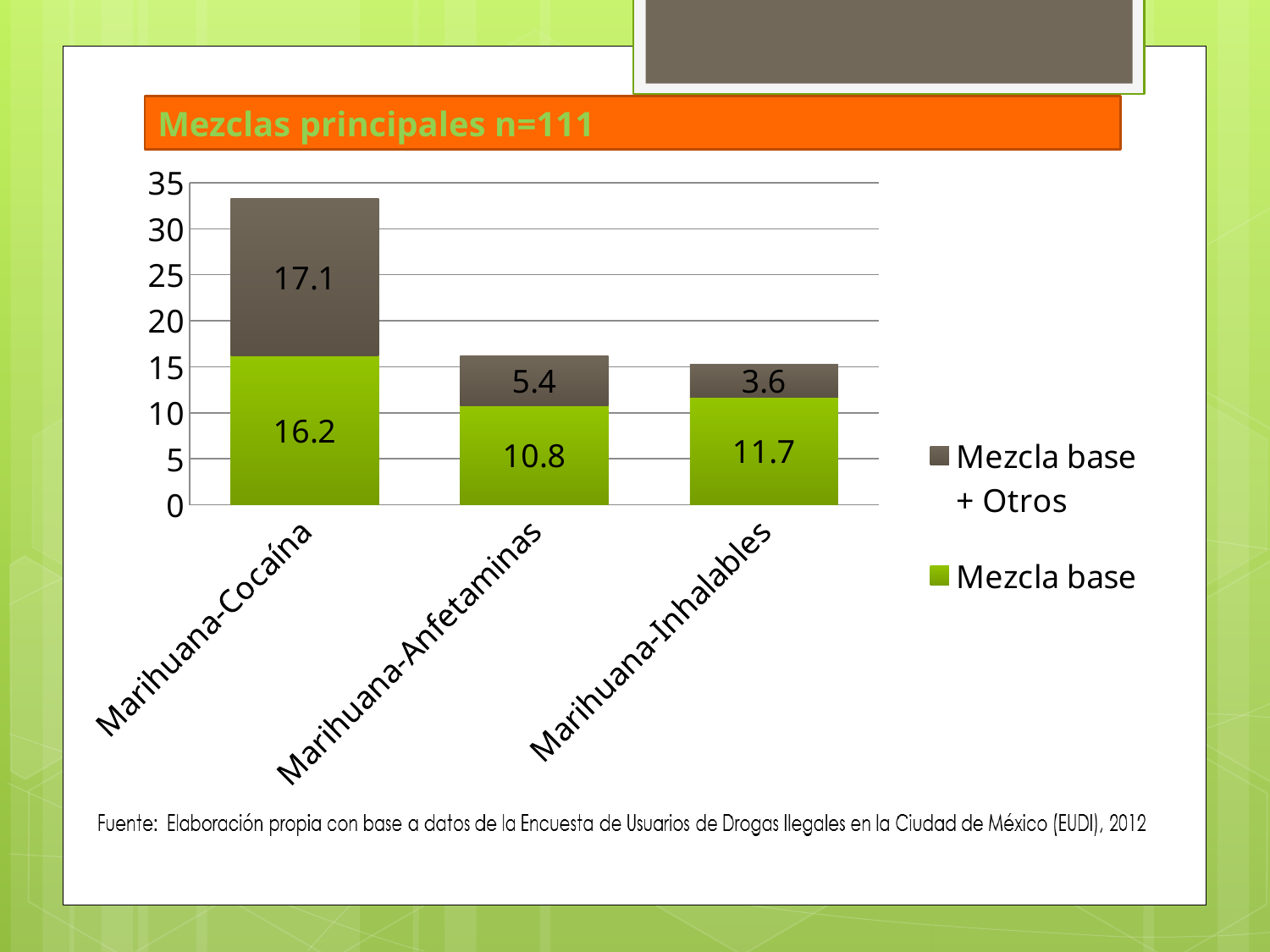
What is the total of the stacked bar for Marihuana-Anfetaminas? 16.2 Which category has the lowest Mezcla base value? Marihuana-Anfetaminas What is the Mezcla base value for Marihuana-Inhalables? 11.7 What kind of chart is shown on the slide? Stacked bar chart Which is larger: the Mezcla base value for Marihuana-Anfetaminas or for Marihuana-Inhalables? Marihuana-Inhalables How many categories are shown on the x axis? 3 What is the total of the stacked bar for Marihuana-Cocaína? 33.3 How many series does the legend list? 2 What is the Mezcla base value for Marihuana-Cocaína? 16.2 What is the difference between the Mezcla base + Otros values for Marihuana-Cocaína and Marihuana-Inhalables? 13.5 Which category has the highest Mezcla base + Otros value? Marihuana-Cocaína What is the Mezcla base + Otros value for Marihuana-Anfetaminas? 5.4